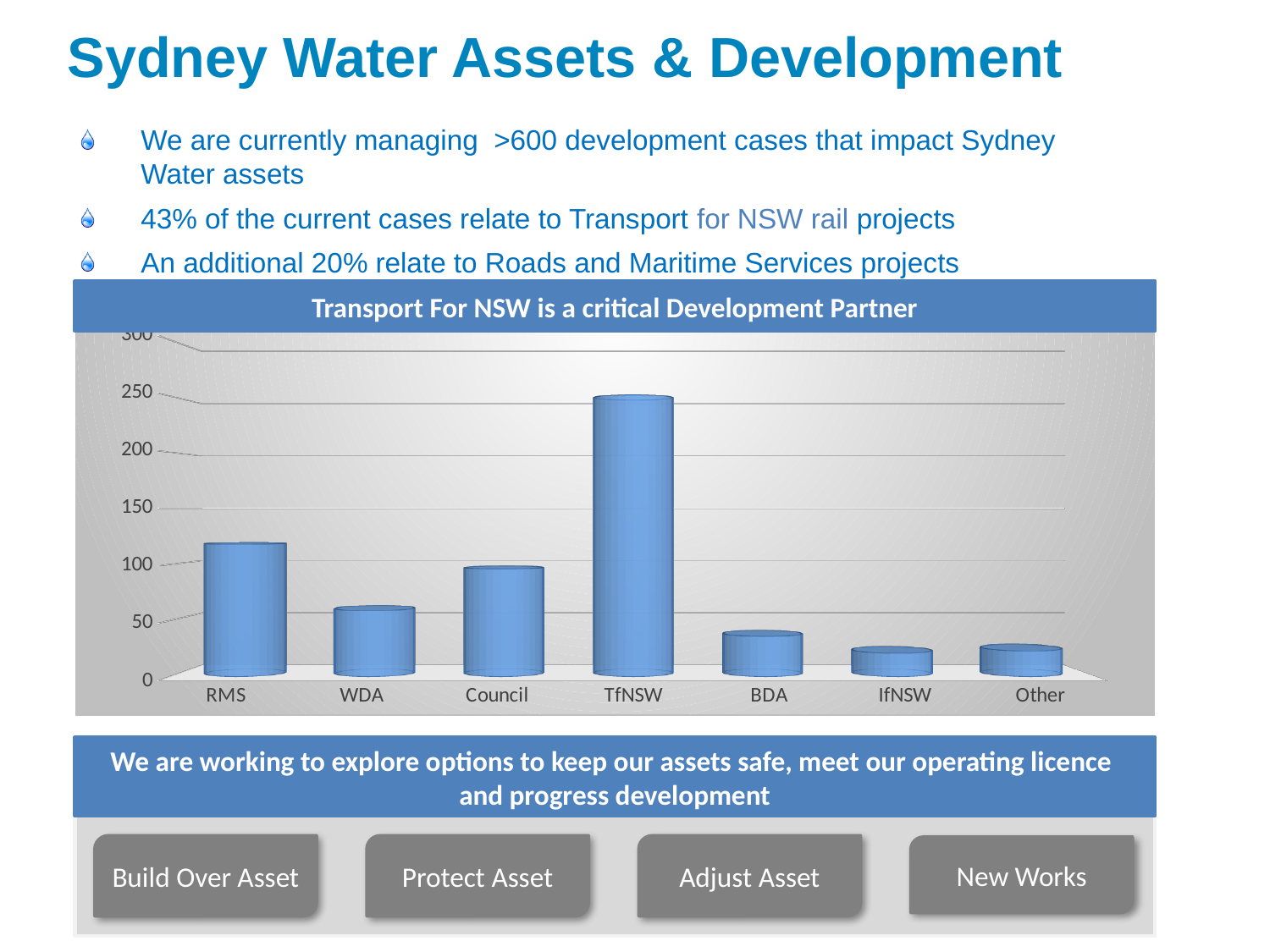
Which has the larger value, RMS or Council? RMS How many categories are shown on the x axis of the chart? 7 Is the value for BDA greater or less than 50? less Is the value for TfNSW greater or less than 200? greater Which category has the highest bar in the chart? TfNSW Is the value for Council greater or less than 150? less What kind of chart is shown on the slide? bar chart What is the title shown above the chart? Transport For NSW is a critical Development Partner Which has the larger value, WDA or BDA? WDA